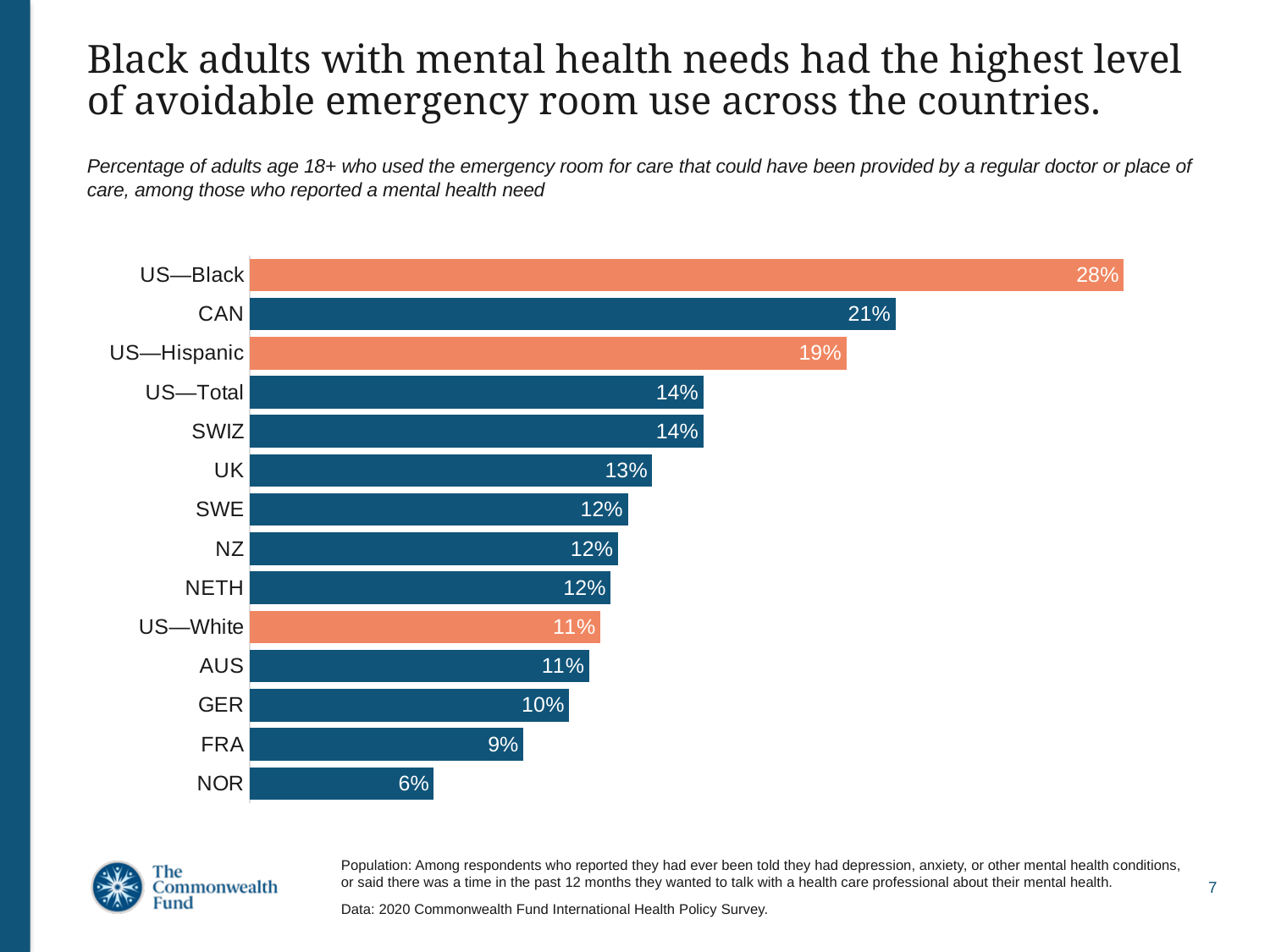
What is the value for NETH? 12% What kind of chart is shown on the slide? Bar chart Which category has the highest value? US—Black Which category has the lowest value? NOR Which is larger, the value for UK or the value for GER? UK What is the value for US—Black? 28% What is the difference between the values for CAN and US—Hispanic? 2% Which categories are shown with orange bars? US—Black, US—Hispanic, US—White What is the difference between the values for US—Black and US—White? 17% How many categories are shown in the chart? 14 What is the value for FRA? 9% What is the value for CAN? 21%